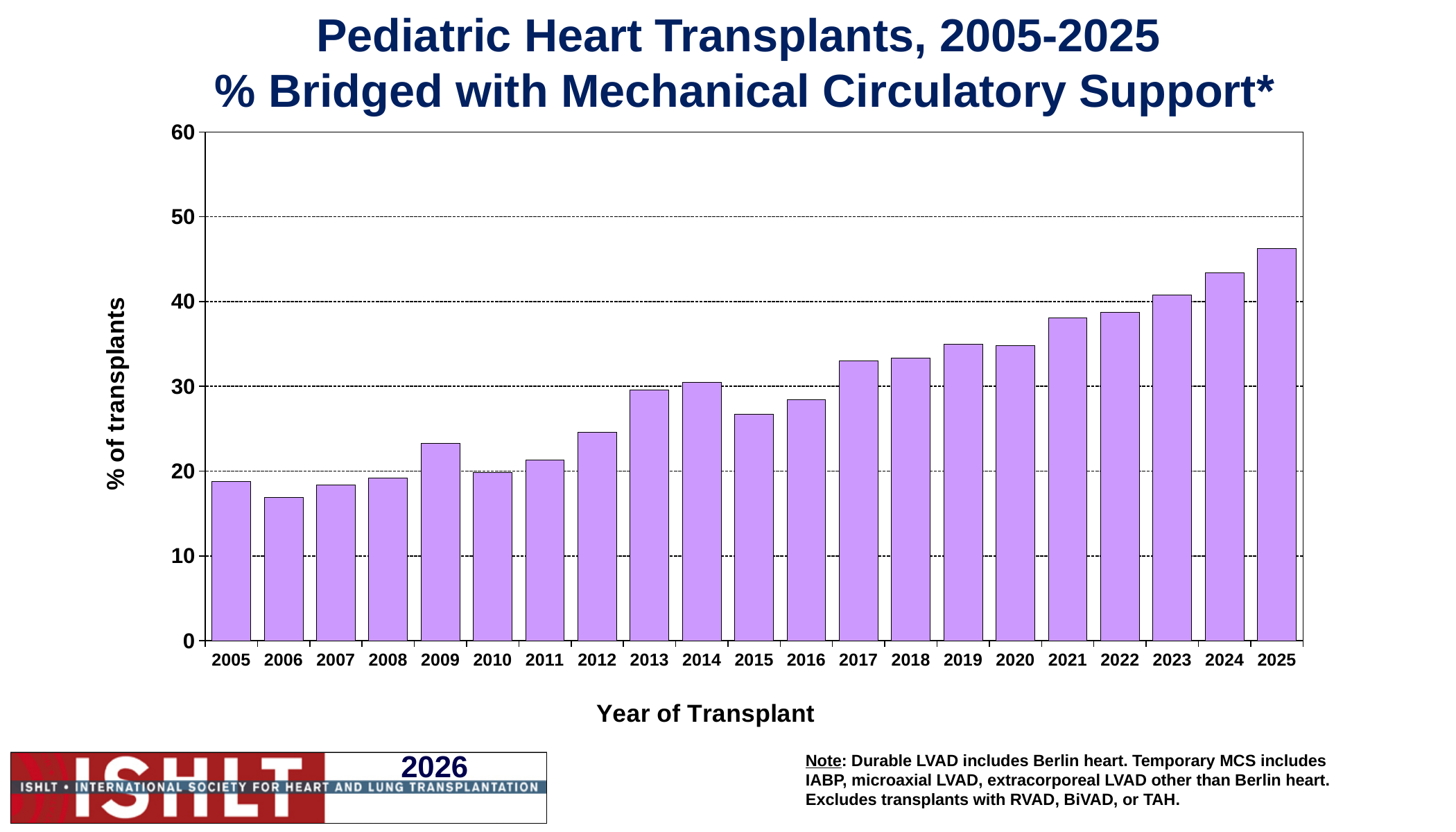
Is the value for 2017 greater or less than 30? greater Overall, do the values rise or fall from 2005 to 2025? rise Is the value for 2015 greater or less than 30? less Which year has the lowest % of transplants bridged with mechanical circulatory support? 2006 Is the value for 2025 greater or less than 40? greater How many years are plotted on the x axis? 21 Which year has the larger value, 2009 or 2010? 2009 Which year has the highest % of transplants bridged with mechanical circulatory support? 2025 Which year has the larger value, 2014 or 2015? 2014 What kind of chart is shown on the slide? bar chart What is the label of the y axis? % of transplants